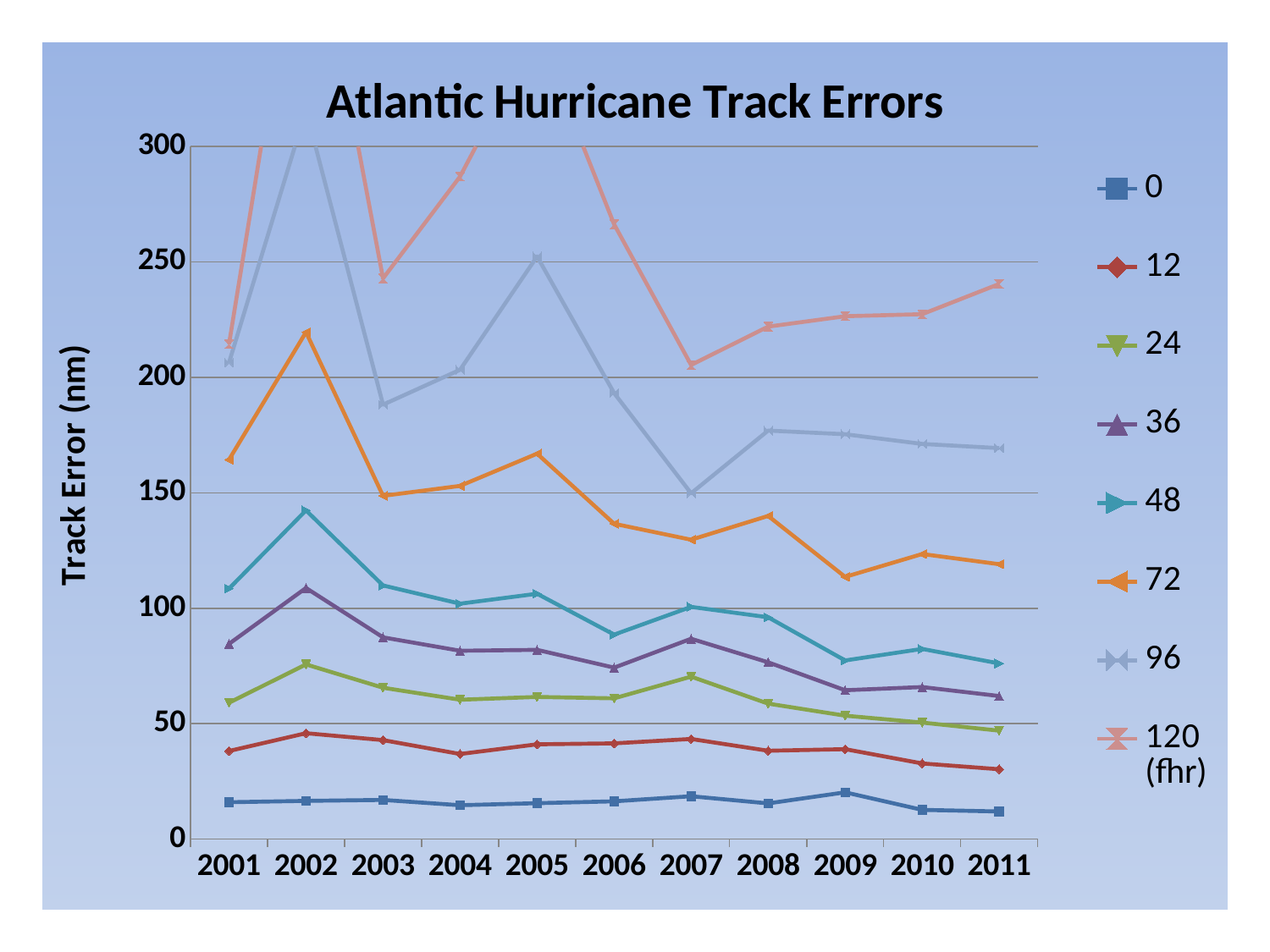
Does the 120 (fhr) series rise or fall from 2007 to 2011? rise Is the value for the 48 series in 2002 greater or less than 150? less What is the label on the y axis? Track Error (nm) Is the value for the 72 series in 2002 greater or less than 200? greater How many series does the legend list? 8 How many years are plotted along the x axis? 11 What kind of chart is shown on the slide? line chart Is the value for the 12 series in 2011 greater or less than 50? less In which year is the 72 series at its highest? 2002 What is the title of the chart? Atlantic Hurricane Track Errors Which is larger for the 48 series: the value in 2001 or the value in 2002? 2002